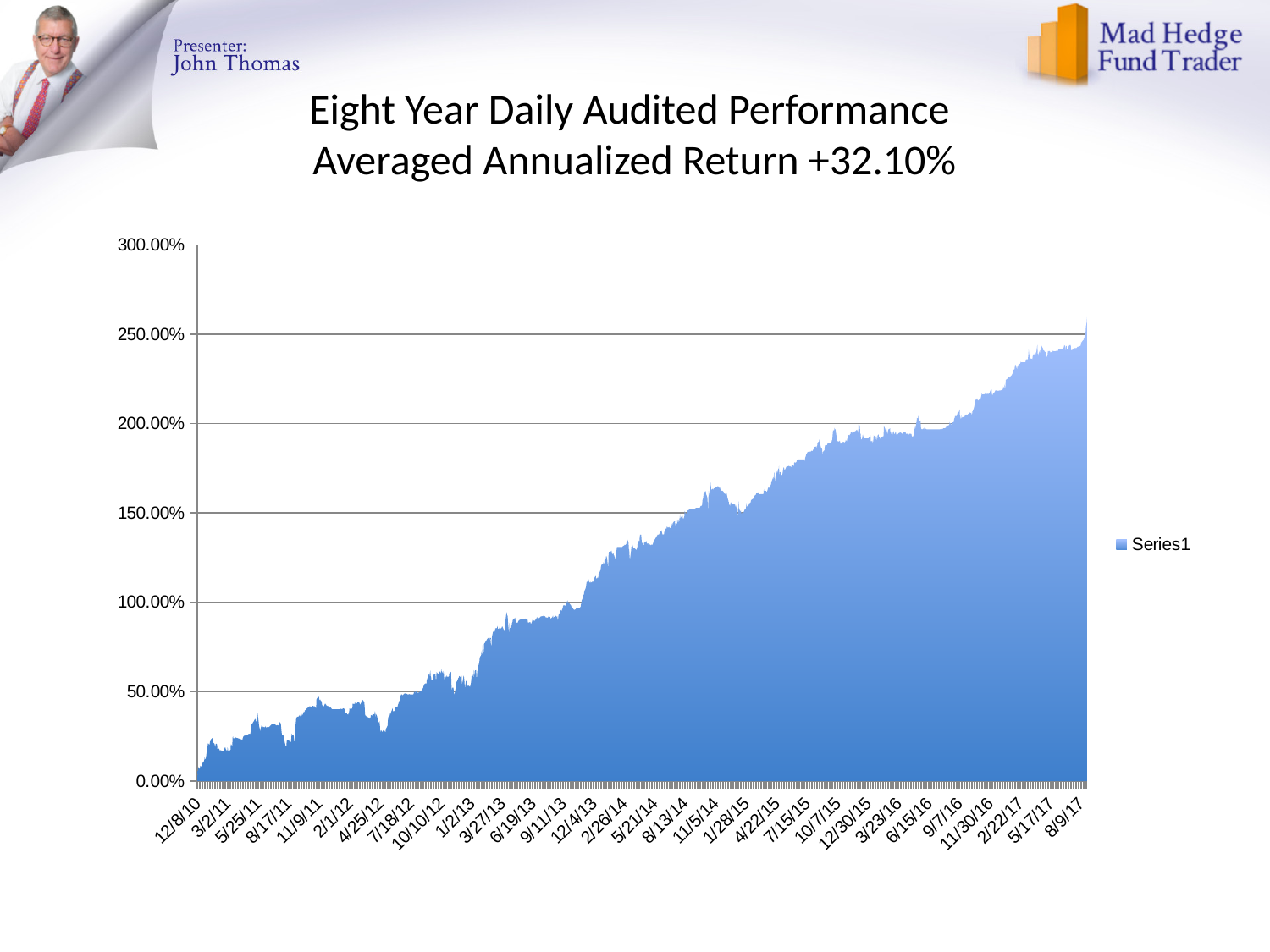
What is the name of the series shown in the legend? Series1 What is the title of the chart on the slide? Eight Year Daily Audited Performance Averaged Annualized Return +32.10% Which date has the larger value for Series1, 12/8/10 or 8/9/17? 8/9/17 Do the values generally rise or fall from 12/8/10 to 8/9/17? rise Is the value for Series1 at 11/9/11 greater or less than 50.00%? less Is the value for Series1 at 7/15/15 greater or less than 200.00%? less Is the value for Series1 at 2/26/14 greater or less than 100.00%? greater At which x-axis date is the value for Series1 lowest? 12/8/10 What kind of chart is shown on the slide? area chart How many series does the legend list? 1